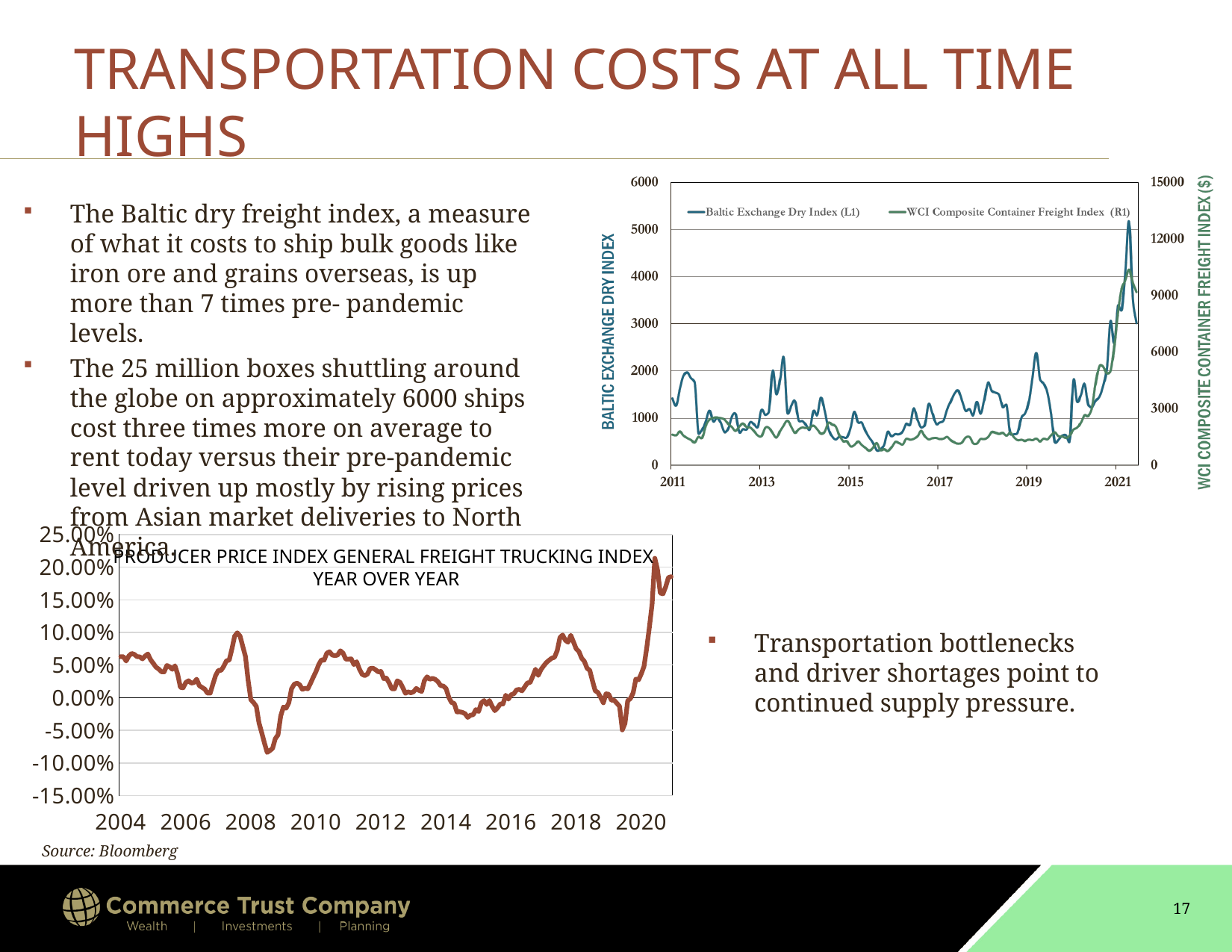
In the top-right chart, does the WCI Composite Container Freight Index rise or fall between 2020 and 2021? Rise In the top-right chart, which series is plotted on the right axis (R1)? WCI Composite Container Freight Index What kind of chart is the bottom-left Producer Price Index General Freight Trucking Index chart? Line chart In the bottom-left chart, is the value in 2014 greater or less than 0.00%? greater In the top-right chart, is the peak value of the Baltic Exchange Dry Index in 2021 greater or less than 4000? greater In the bottom-left chart, is the highest value reached around 2021 greater or less than 20.00%? greater What kind of chart is the top-right chart showing the Baltic Exchange Dry Index? Line chart In the bottom-left chart, does the Producer Price Index General Freight Trucking Index rise or fall from 2020 to 2021? Rise What is the title of the bottom-left chart? Producer Price Index General Freight Trucking Index Year over Year How many series does the legend of the top-right chart list? 2